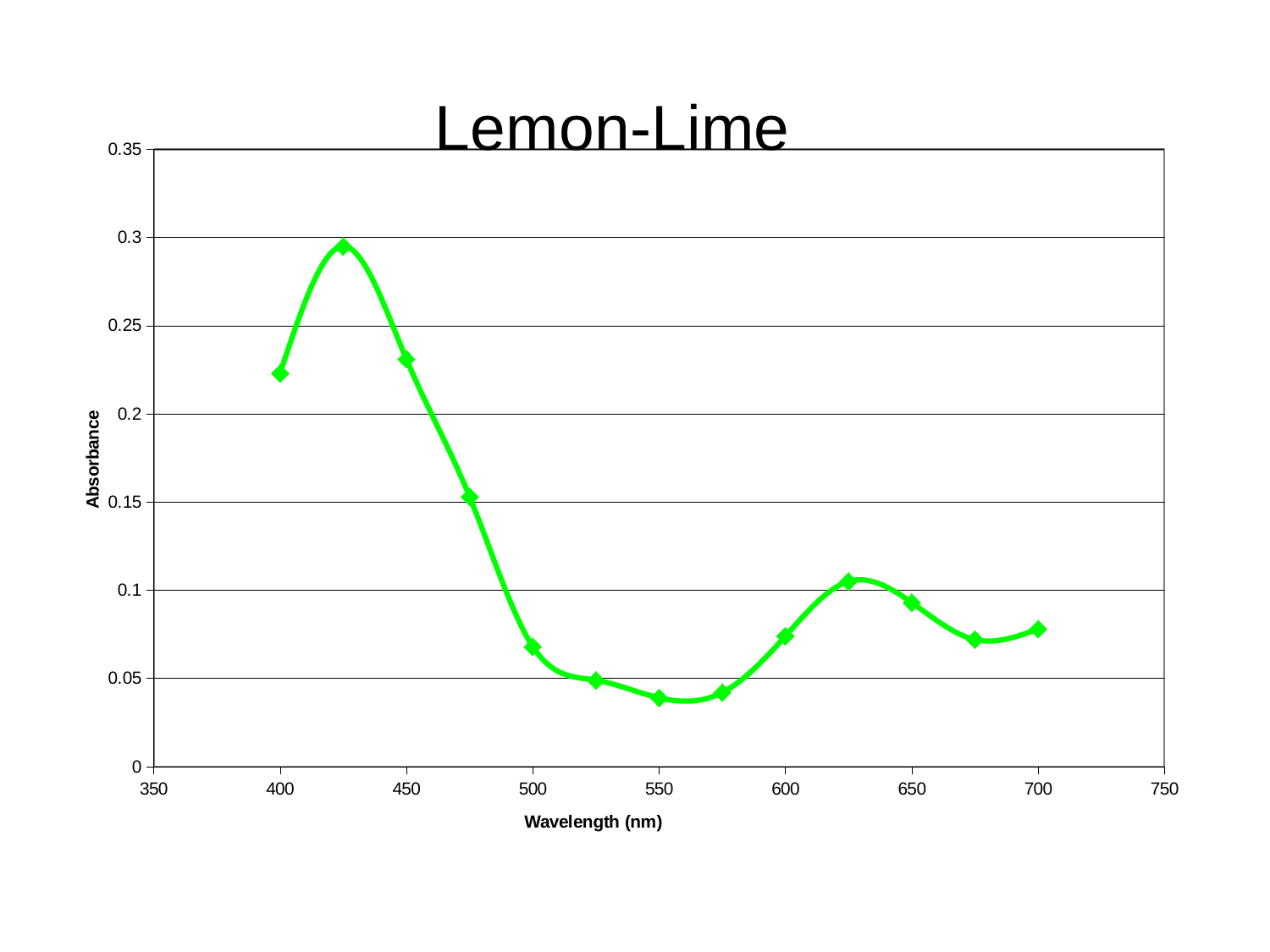
What is the label of the x axis? Wavelength (nm) Is the absorbance at 550 nm greater or less than 0.05? less Is the absorbance at 400 nm greater or less than 0.2? greater Is the absorbance at 425 nm greater or less than 0.25? greater Does the absorbance rise or fall between 425 nm and 550 nm? fall How many data points are plotted on the line? 13 At which wavelength is the absorbance highest? 425 Which has the higher absorbance, 450 nm or 600 nm? 450 nm What kind of chart is shown on the slide? line chart What is the title of the chart? Lemon-Lime